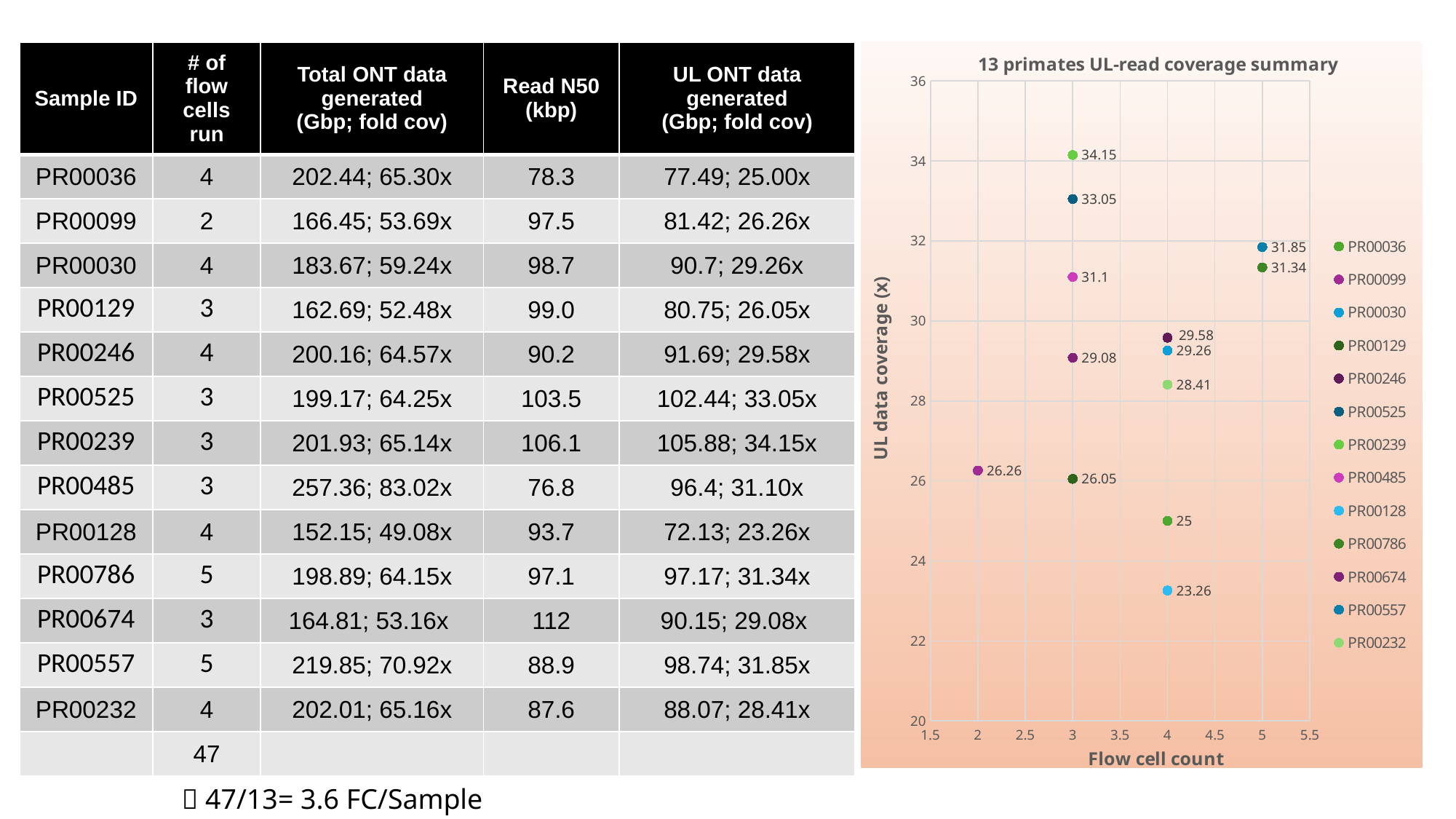
In the chart, what is the UL data coverage of the only point plotted at a flow cell count of 2? 26.26 What is the label of the x axis of the chart? Flow cell count What is the title of the chart on the right of the slide? 13 primates UL-read coverage summary In the chart, is the point labelled 23.26 above or below 24 on the y axis? below In the chart, what is the UL data coverage of the point labelled 25, and at what flow cell count is it plotted? 25 at flow cell count 4 In the chart, what is the difference between the highest and lowest plotted UL data coverage values? 10.89 What is the lowest UL data coverage value plotted in the chart? 23.26 In the chart, which is larger: the higher of the two points at flow cell count 5 (31.85) or the point labelled 31.1 at flow cell count 3? 31.85 What kind of chart is shown on the right of the slide? scatter chart How many series does the legend of the chart list? 13 How many data points are plotted in the chart? 13 What is the highest UL data coverage value plotted in the chart? 34.15